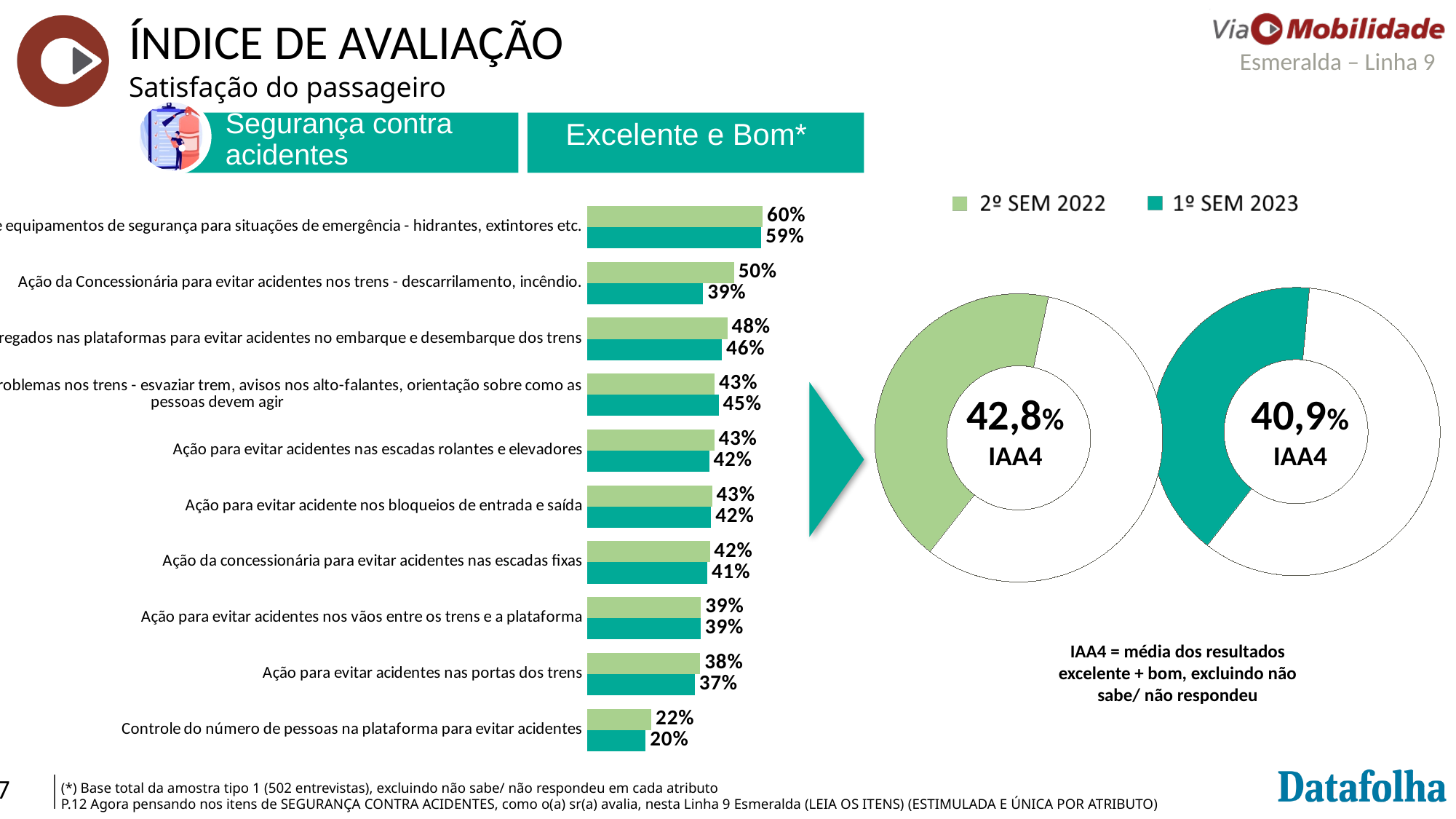
In the bar chart, which category has the lowest 1º SEM 2023 value? Controle do número de pessoas na plataforma para evitar acidentes In the bar chart, what is the 2º SEM 2022 value for 'Controle do número de pessoas na plataforma para evitar acidentes'? 22% In the bar chart, which is larger for 'Ação para evitar acidentes nas escadas rolantes e elevadores': the 2º SEM 2022 value or the 1º SEM 2023 value? 2º SEM 2022 How many categories does the bar chart show? 10 Which series in the bar chart legend is shown in light green? 2º SEM 2022 How many series does the legend of the bar chart list? 2 In the left donut chart (2º SEM 2022), what is the IAA4 value? 42,8% What type of chart is used to show the values by attribute on the left side of the slide? Bar chart In the right donut chart (1º SEM 2023), what is the IAA4 value? 40,9% In the bar chart, what is the 1º SEM 2023 value for 'Ação da Concessionária para evitar acidentes nos trens - descarrilamento, incêndio.'? 39% In the bar chart, what is the difference between the 2º SEM 2022 and 1º SEM 2023 values for 'Ação da Concessionária para evitar acidentes nos trens - descarrilamento, incêndio.'? 11 percentage points In the bar chart, what is the 1º SEM 2023 value for 'Ação para evitar acidentes nas portas dos trens'? 37%